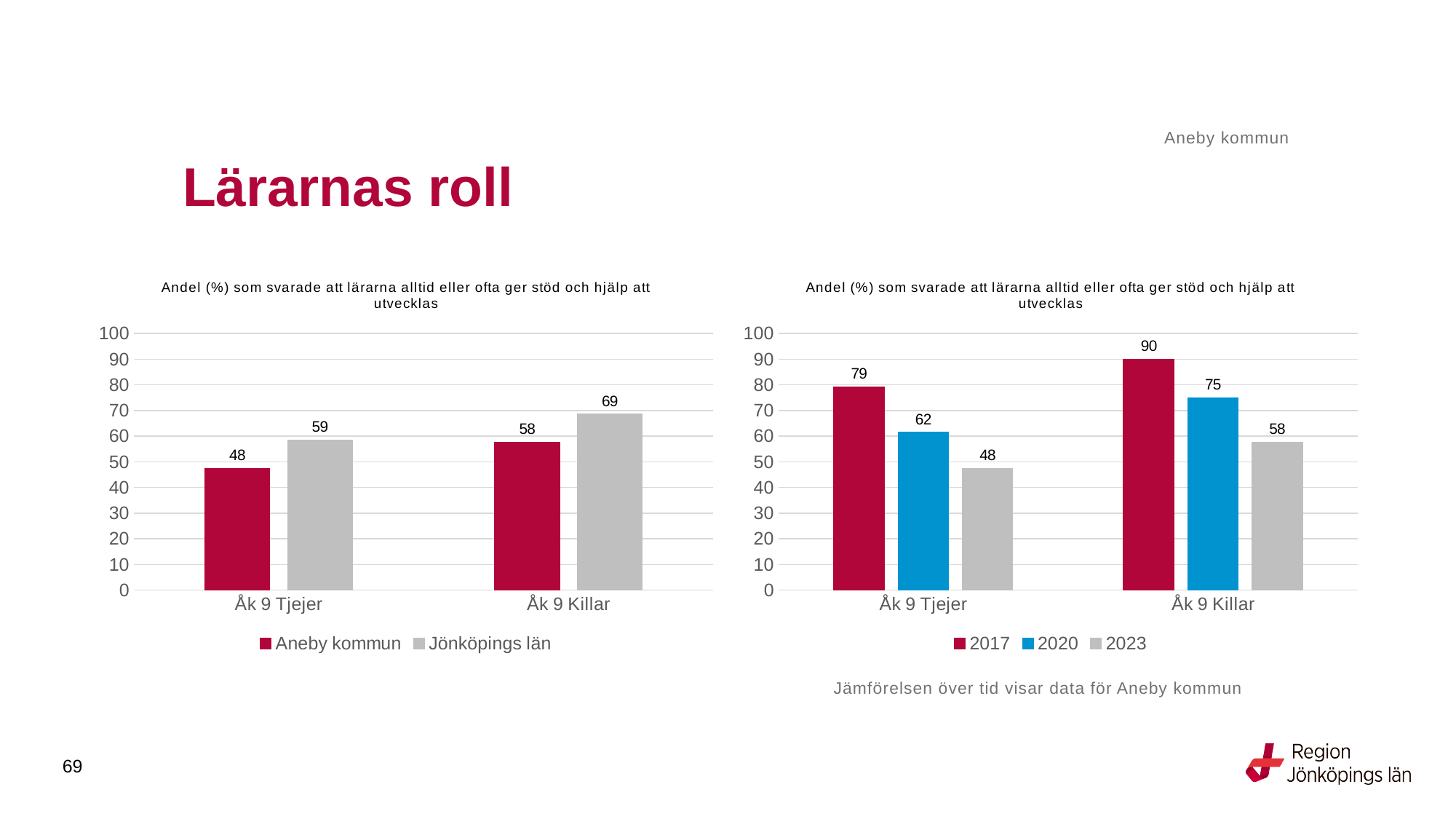
In the left chart, which is larger for Åk 9 Killar: Aneby kommun or Jönköpings län? Jönköpings län In the left chart, what is the value for Aneby kommun for Åk 9 Tjejer? 48 In the right chart, how many series does the legend list? 3 In the left chart, how many series does the legend list? 2 In the right chart, do the values for Åk 9 Tjejer rise or fall from 2017 to 2023? fall What kind of chart is the left chart? bar chart In the right chart, what is the value for 2023 for Åk 9 Tjejer? 48 In the right chart, what is the difference between 2017 and 2023 for Åk 9 Killar? 32 In the right chart, which year has the highest value for Åk 9 Killar? 2017 In the left chart, what is the value for Jönköpings län for Åk 9 Killar? 69 In the right chart, what is the value for 2020 for Åk 9 Killar? 75 In the left chart, what is the difference between Jönköpings län and Aneby kommun for Åk 9 Tjejer? 11